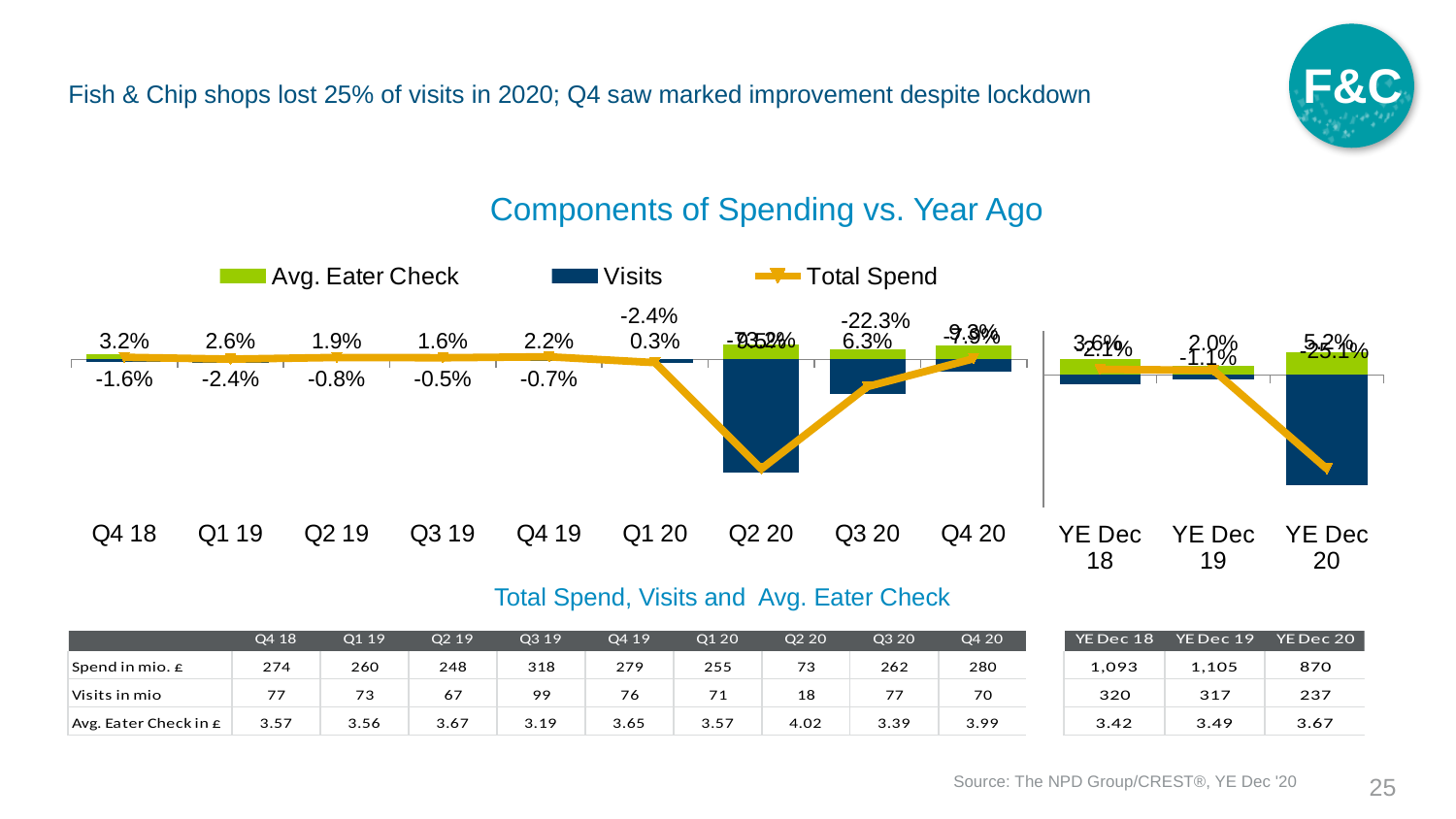
What is the title of the chart? Components of Spending vs. Year Ago Does the Avg. Eater Check value rise or fall from Q4 18 to Q3 19? fall What kind of chart is used for the Avg. Eater Check and Visits series? bar chart How many series does the chart legend list? 3 What is the Visits value for Q3 20? -22.3% What is the Avg. Eater Check value for Q3 20? 6.3% In which quarter is the Visits value lowest? Q2 20 What is the Avg. Eater Check value for Q4 18? 3.2% What is the difference between the Avg. Eater Check values for Q4 18 and Q1 19? 0.6 percentage points How many quarterly categories are shown on the left panel of the chart (from Q4 18 to Q4 20)? 9 What is the Visits value for Q1 19? -2.4% Which is larger, the Visits value for Q1 19 or for Q2 19? Q2 19